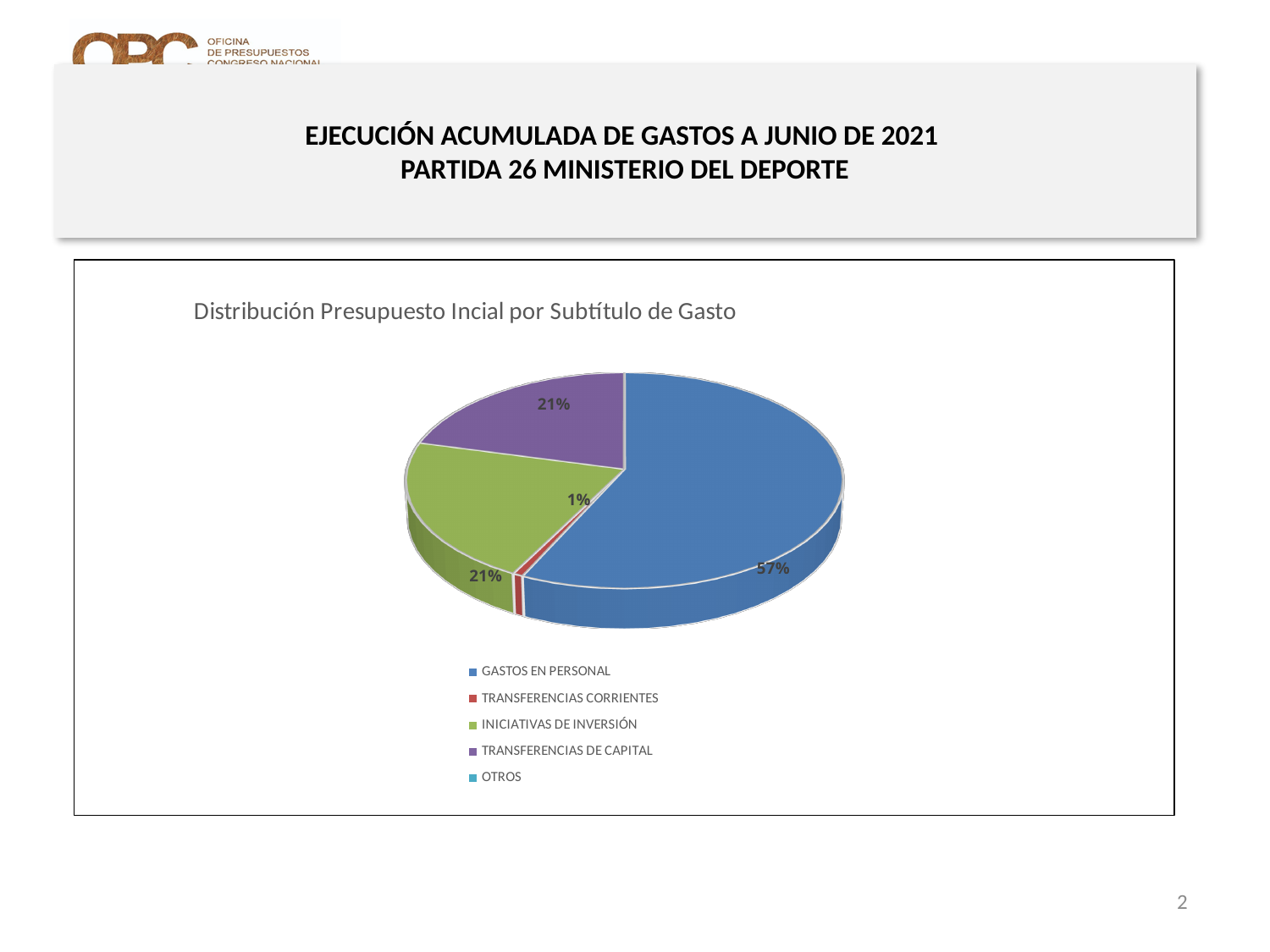
What percentage of the pie does GASTOS EN PERSONAL represent? 57% What percentage of the pie does TRANSFERENCIAS DE CAPITAL represent? 21% What is the title of the chart? Distribución Presupuesto Incial por Subtítulo de Gasto Which is larger, the share for GASTOS EN PERSONAL or the share for INICIATIVAS DE INVERSIÓN? GASTOS EN PERSONAL How many entries does the chart legend list? 5 How many percentage points larger is the GASTOS EN PERSONAL slice than the TRANSFERENCIAS DE CAPITAL slice? 36 percentage points What percentage of the pie does INICIATIVAS DE INVERSIÓN represent? 21% Among the slices with a printed percentage, which category has the smallest share? TRANSFERENCIAS CORRIENTES Which category has the largest slice of the pie? GASTOS EN PERSONAL What colour is the slice for TRANSFERENCIAS DE CAPITAL? Purple What percentage of the pie does TRANSFERENCIAS CORRIENTES represent? 1% What type of chart is shown on the slide? Pie chart